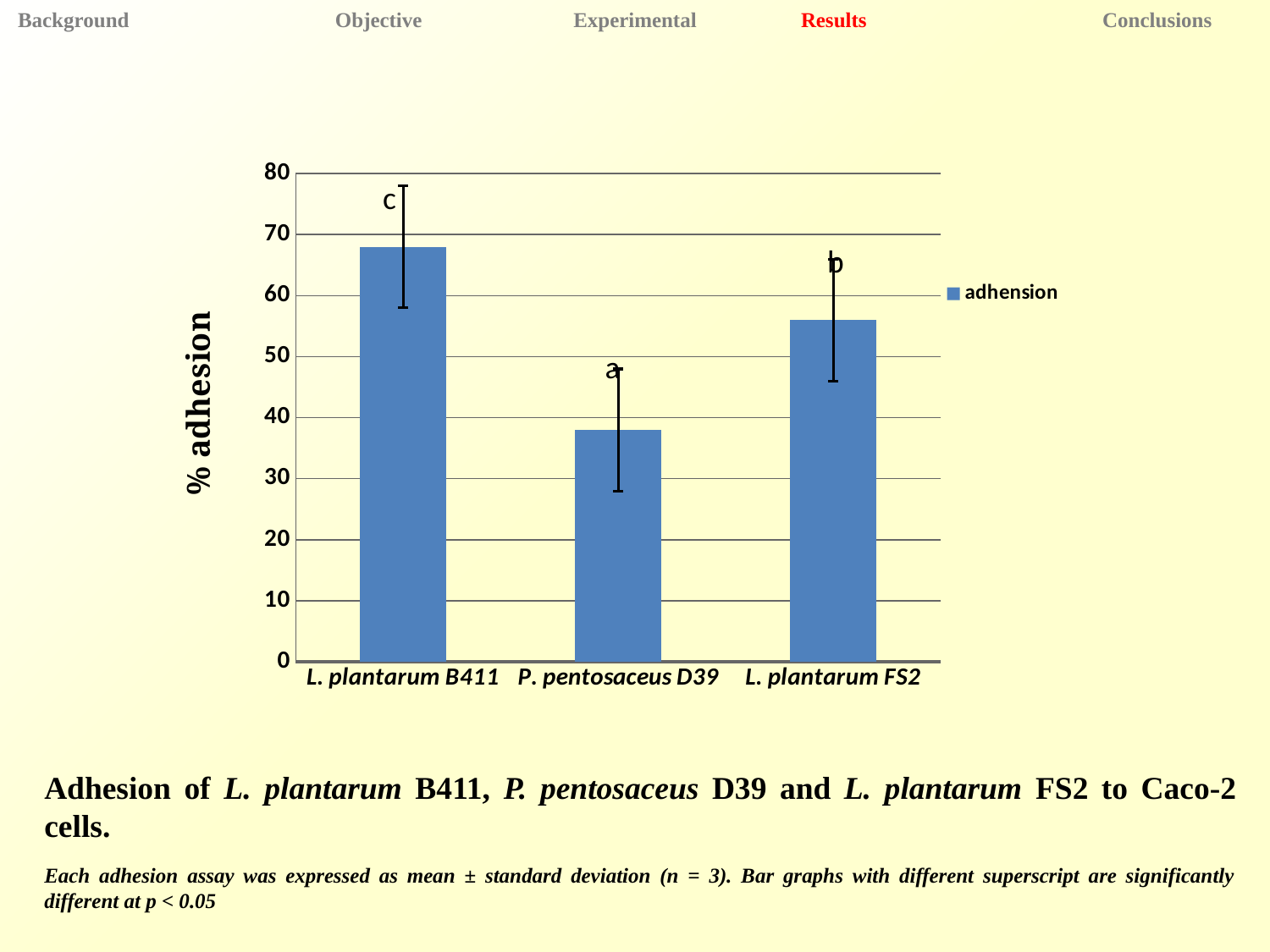
How many bacterial strains (categories) are plotted on the x axis? 3 Is the % adhesion for P. pentosaceus D39 greater or less than 50? less Is the % adhesion for L. plantarum B411 greater or less than 60? greater Which strain has the lowest % adhesion? P. pentosaceus D39 What superscript letter is shown above the bar for P. pentosaceus D39? a How many series does the legend list? 1 Which has a higher % adhesion, P. pentosaceus D39 or L. plantarum FS2? L. plantarum FS2 Which strain has the highest % adhesion? L. plantarum B411 Is the % adhesion for L. plantarum FS2 greater or less than 50? greater Which has a higher % adhesion, L. plantarum B411 or L. plantarum FS2? L. plantarum B411 What kind of chart is shown on the slide? bar chart What is the label on the y axis of the chart? % adhesion